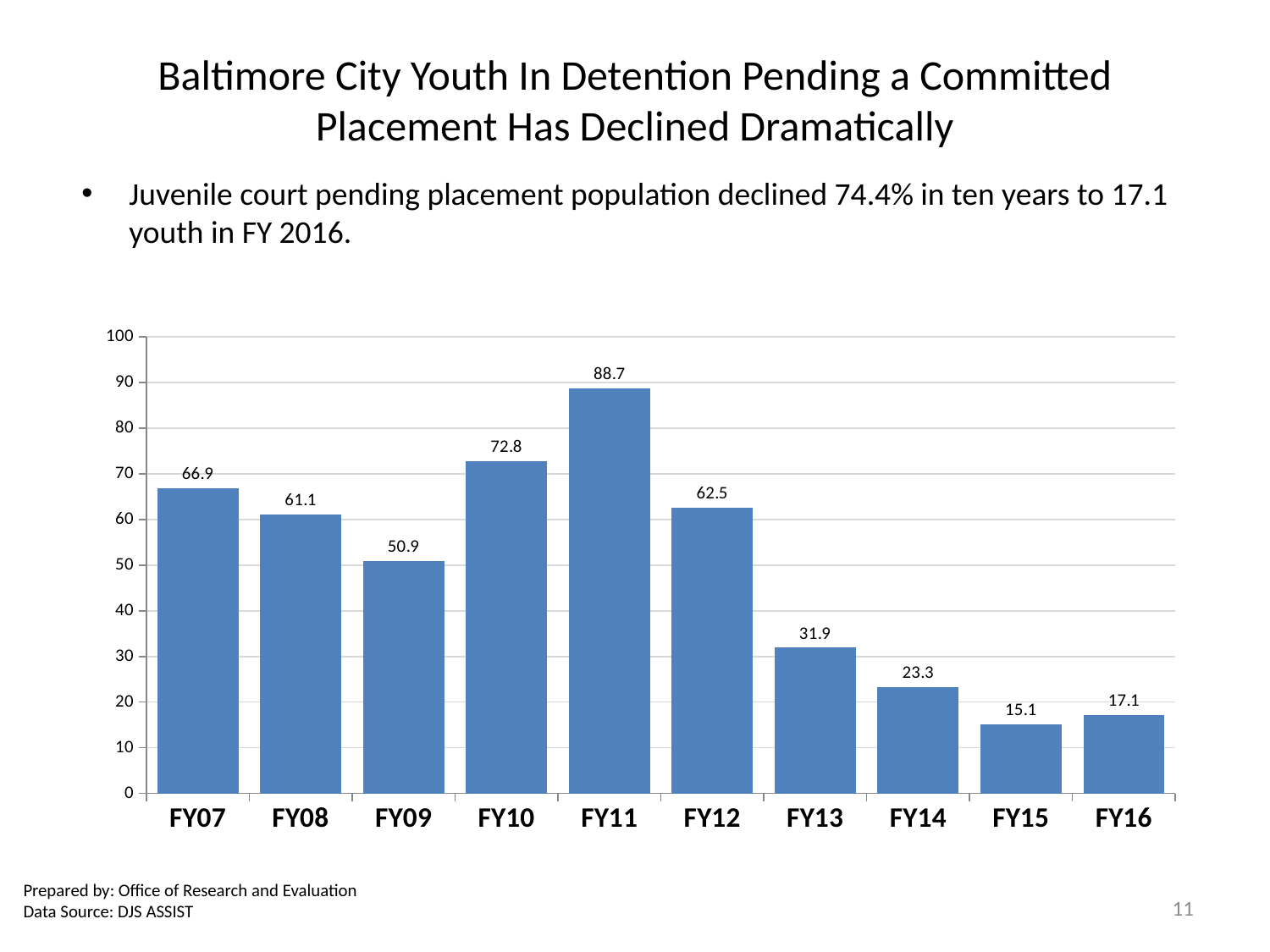
How many fiscal years are shown on the x axis? 10 Which fiscal year has the highest value? FY11 Which is larger, the value for FY08 or the value for FY10? FY10 What is the value for FY09? 50.9 What is the difference between the values for FY11 and FY12? 26.2 What is the value for FY11? 88.7 Is the value for FY13 greater or less than 40? less What kind of chart is shown on the slide? bar chart What is the value for FY16? 17.1 What is the difference between the values for FY07 and FY16? 49.8 Which fiscal year has the lowest value? FY15 Do the values rise or fall from FY11 to FY15? fall